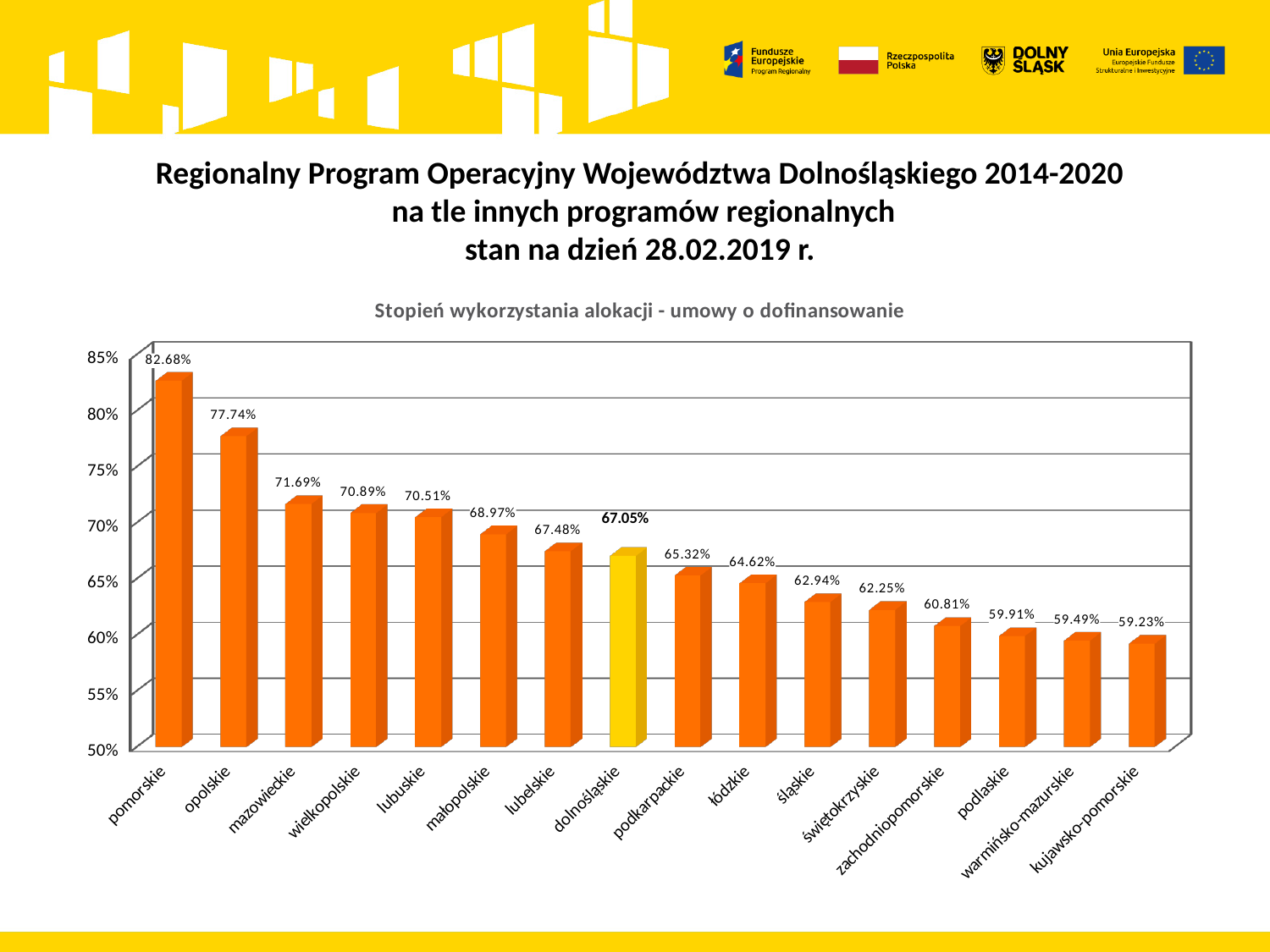
How many categories are shown on the x axis? 16 Do the values rise or fall from left to right along the x axis? fall Is the value for śląskie greater or less than 65%? less What is the value for zachodniopomorskie? 60.81% What is the value for pomorskie? 82.68% Which is larger, the value for lubelskie or the value for podkarpackie? lubelskie Which category has the lowest value? kujawsko-pomorskie What is the difference between the values for pomorskie and opolskie? 4.94% What kind of chart is shown on the slide? bar chart What is the value for dolnośląskie? 67.05% What is the title of the chart? Stopień wykorzystania alokacji - umowy o dofinansowanie Which category has the highest value? pomorskie